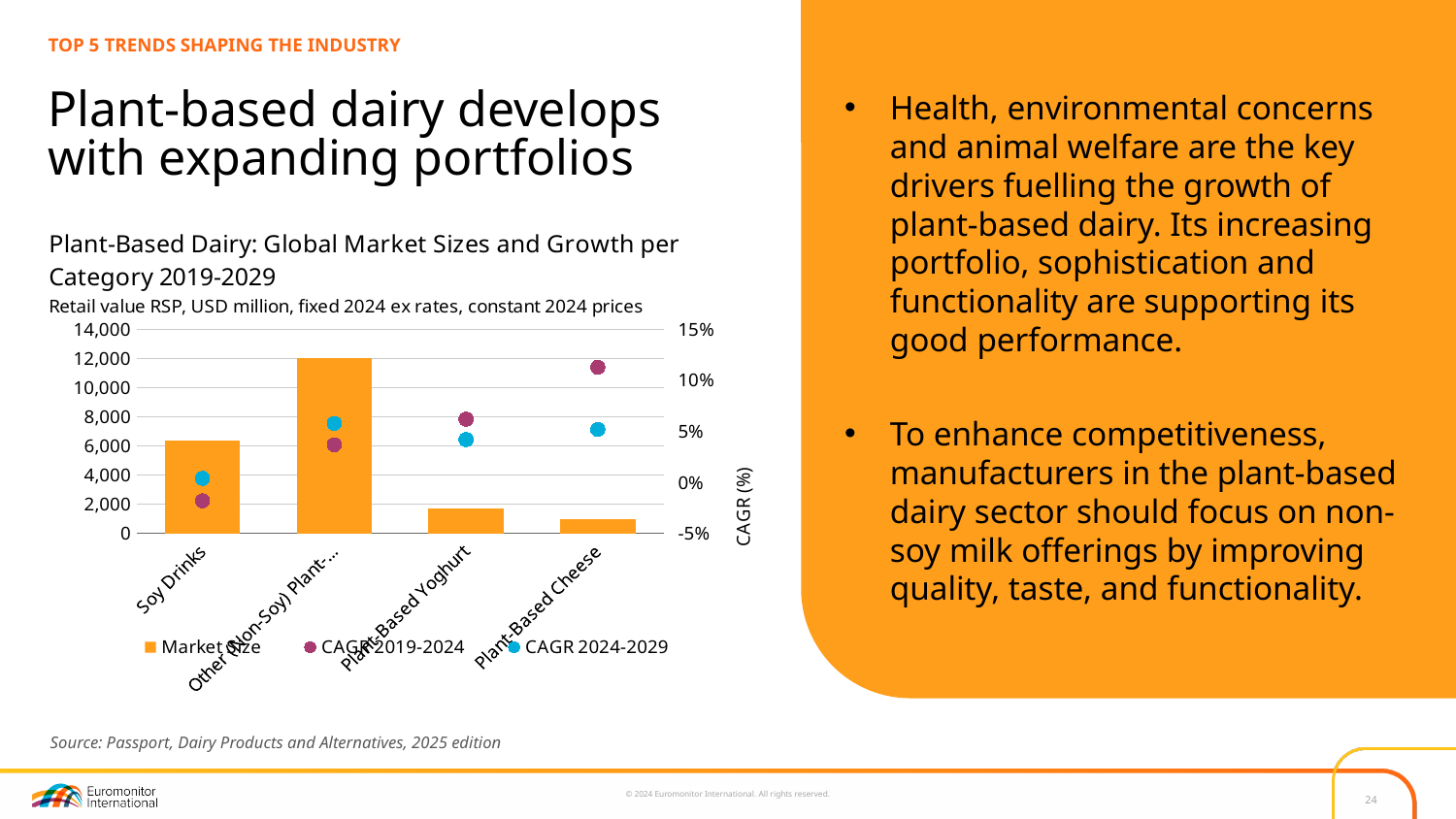
Which has the larger market size, Soy Drinks or Plant-Based Yoghurt? Soy Drinks How many categories are shown on the x axis of the chart? 4 Which category has the smallest market size bar? Plant-Based Cheese Which category has the largest market size bar? Other (Non-Soy) Plant-... Which category has the lowest CAGR 2019-2024? Soy Drinks Is the market size for Soy Drinks greater or less than 8,000? less Is the market size for Other (Non-Soy) Plant-... greater or less than 10,000? greater Is the market size for Plant-Based Yoghurt greater or less than 4,000? less What is the label on the right-hand vertical axis of the chart? CAGR (%) Which category has the highest CAGR 2019-2024? Plant-Based Cheese How many series does the chart legend list? 3 What kind of chart is used to show the market size values? Bar chart (with dot markers for the CAGR series)